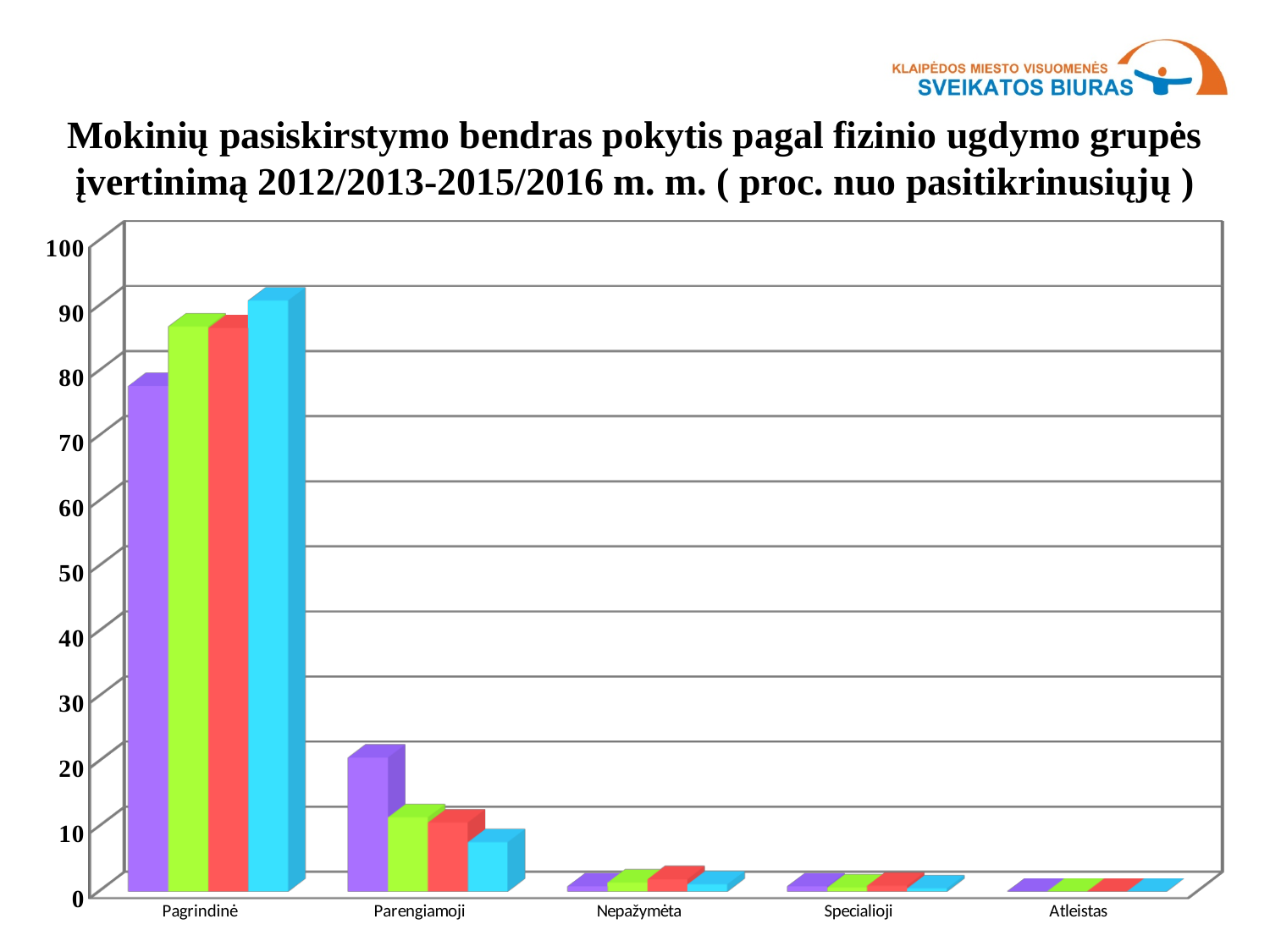
What kind of chart is shown on the slide? bar chart How many categories are shown on the x axis of the chart? 5 How many bars are plotted for each category in the chart? 4 Which category has the highest values in the chart? Pagrindinė Which category has larger values, Pagrindinė or Parengiamoji? Pagrindinė What is the highest value shown on the vertical axis of the chart? 100 Do the values generally rise or fall moving from left to right along the x axis? fall Are the values for Nepažymėta greater or less than 10? less Is the value of the purple bar for Parengiamoji greater or less than 10? greater Is the value of the purple bar for Pagrindinė greater or less than 70? greater